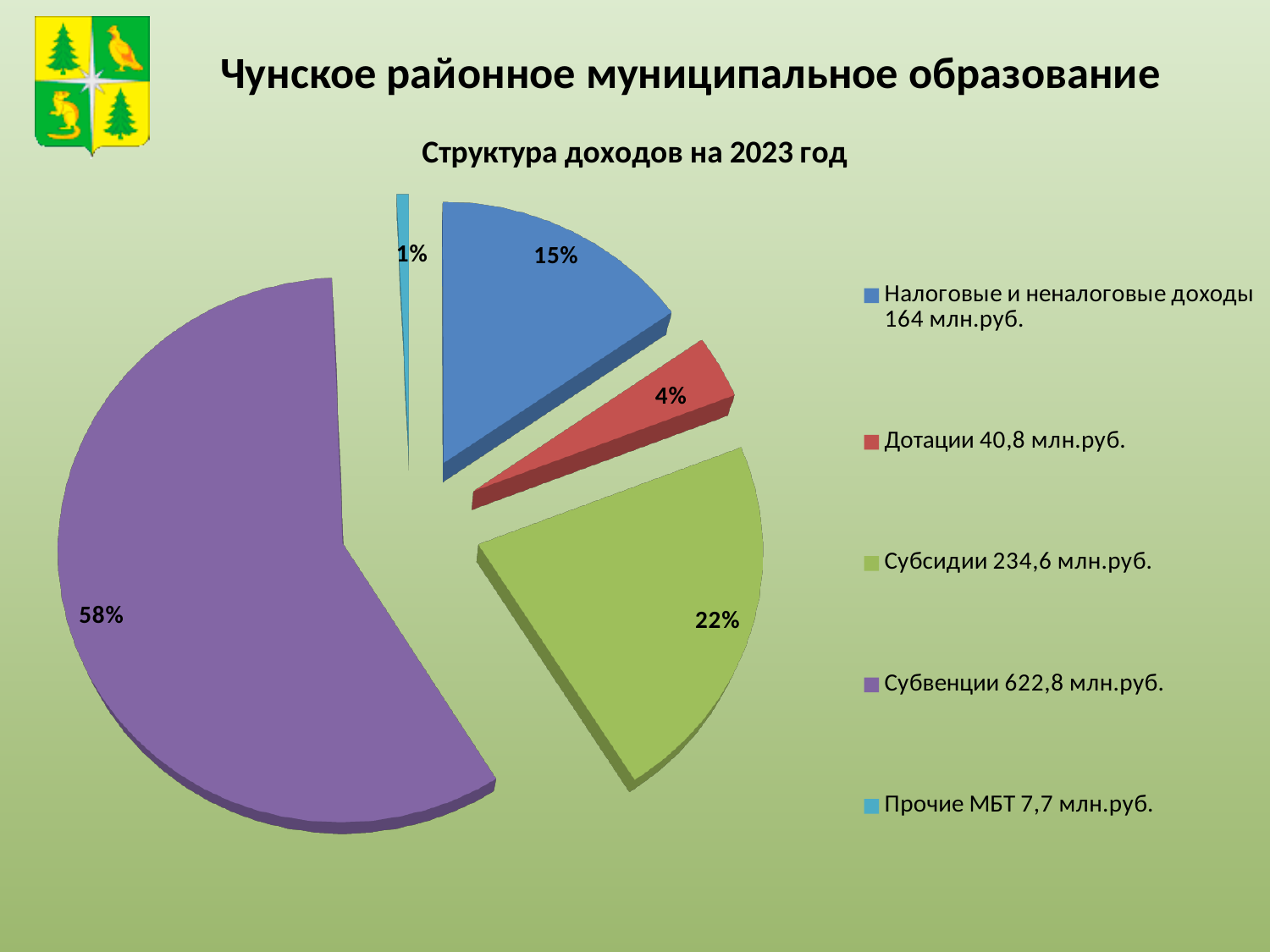
What share of the pie does Субсидии account for? 22% What is the title of the chart? Структура доходов на 2023 год What share of the pie does Налоговые и неналоговые доходы account for? 15% Which category has the smallest slice of the pie? Прочие МБТ Which slice is larger, Налоговые и неналоговые доходы or Дотации? Налоговые и неналоговые доходы What kind of chart is shown on the slide? Pie chart What is the difference in percentage points between the Субвенции slice and the Субсидии slice? 36 percentage points What share of the pie does Дотации account for? 4% How many categories are shown in the pie chart? 5 Which category has the largest slice of the pie? Субвенции